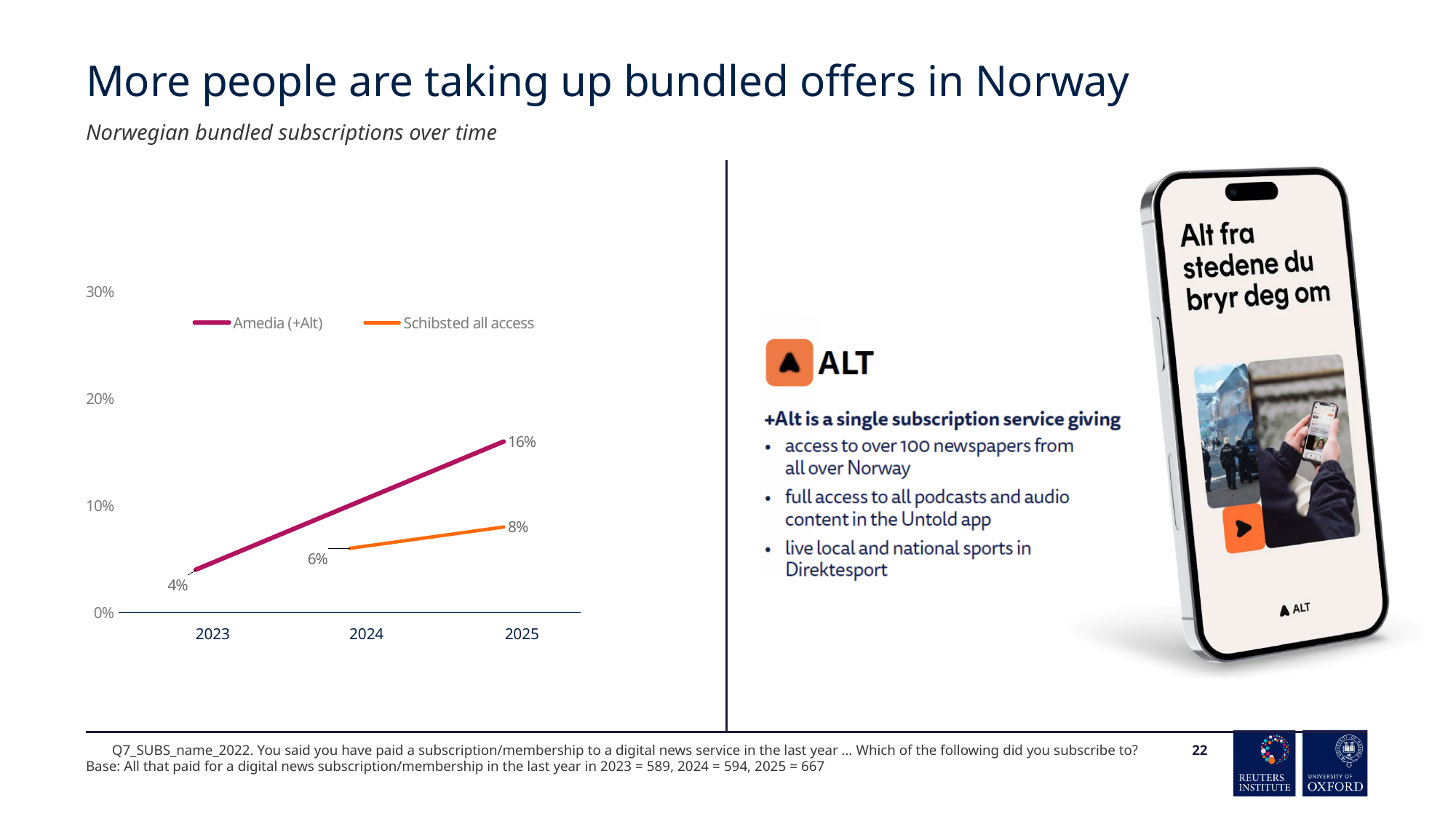
What colour is the line for Schibsted all access? orange What is the value for Amedia (+Alt) in 2025? 16% By how many percentage points did Amedia (+Alt) grow from 2023 to 2025? 12 percentage points What is the difference between Amedia (+Alt) and Schibsted all access in 2025? 8 percentage points Which series has the higher value in 2025, Amedia (+Alt) or Schibsted all access? Amedia (+Alt) What is the value for Amedia (+Alt) in 2023? 4% Is the value for Amedia (+Alt) in 2024 greater or less than 20%? less What is the value for Schibsted all access in 2025? 8% What is the value for Schibsted all access in 2024? 6% How many series does the chart legend list? 2 What kind of chart is shown on the slide? line chart Does the Amedia (+Alt) line rise or fall from 2023 to 2025? rise